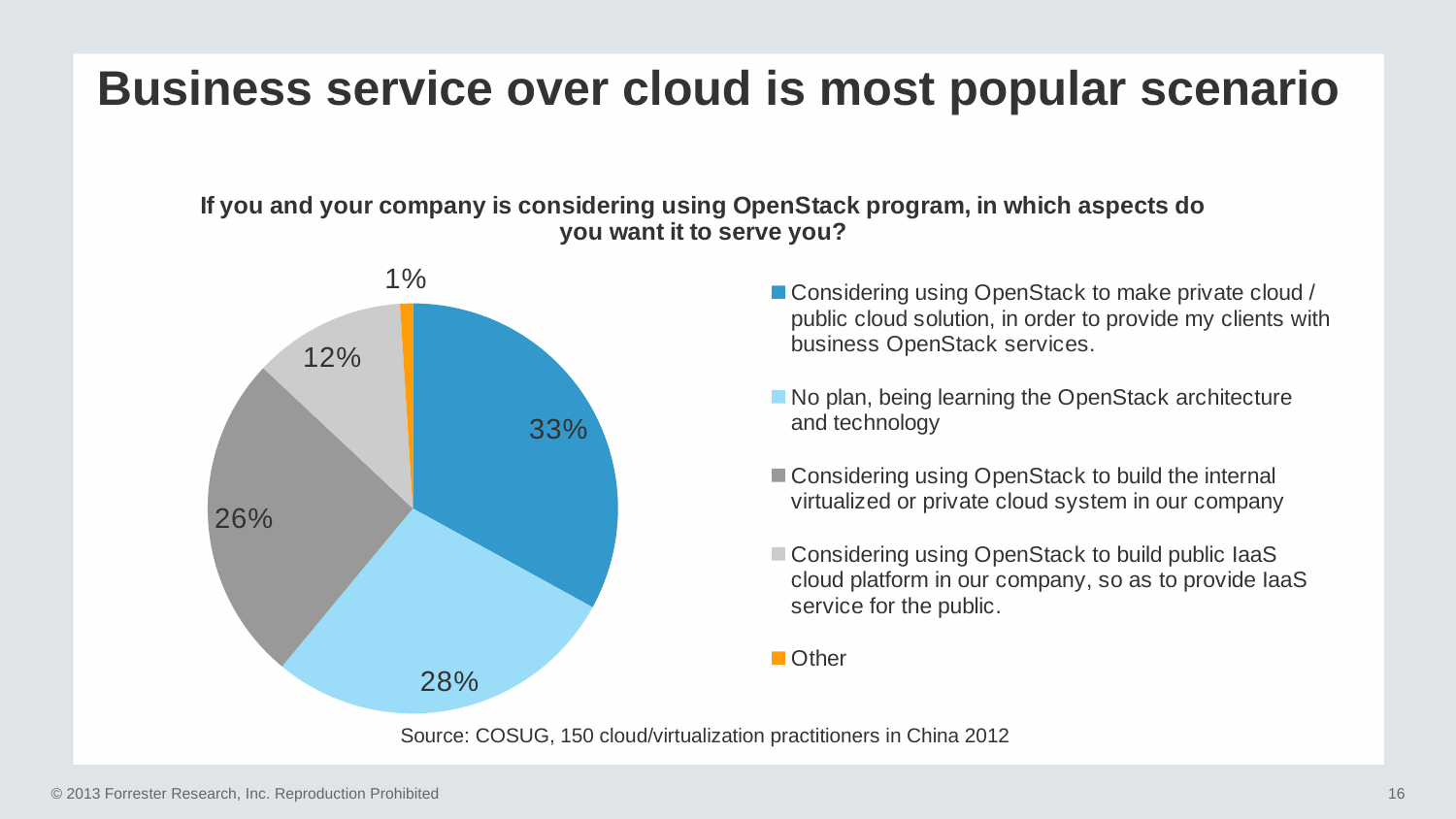
What is the difference in percentage points between the 'No plan, being learning the OpenStack architecture and technology' slice and the 'Considering using OpenStack to build the internal virtualized or private cloud system in our company' slice? 2 percentage points What percentage of respondents have no plan and are learning the OpenStack architecture and technology? 28% How many slices does the pie chart have? 5 Which slice of the pie is the smallest? Other What kind of chart is shown on the slide? pie chart What colour is the 'Other' slice in the pie chart? orange Which slice of the pie is the largest? Considering using OpenStack to make private cloud / public cloud solution, in order to provide my clients with business OpenStack services. What percentage of respondents are considering using OpenStack to build a public IaaS cloud platform in their company? 12% Which is larger: the share for building a public IaaS cloud platform or the share for building the internal virtualized or private cloud system? building the internal virtualized or private cloud system How many entries does the legend list? 5 What share of the pie is labelled 'Other'? 1% What percentage of respondents are considering using OpenStack to build the internal virtualized or private cloud system in their company? 26%